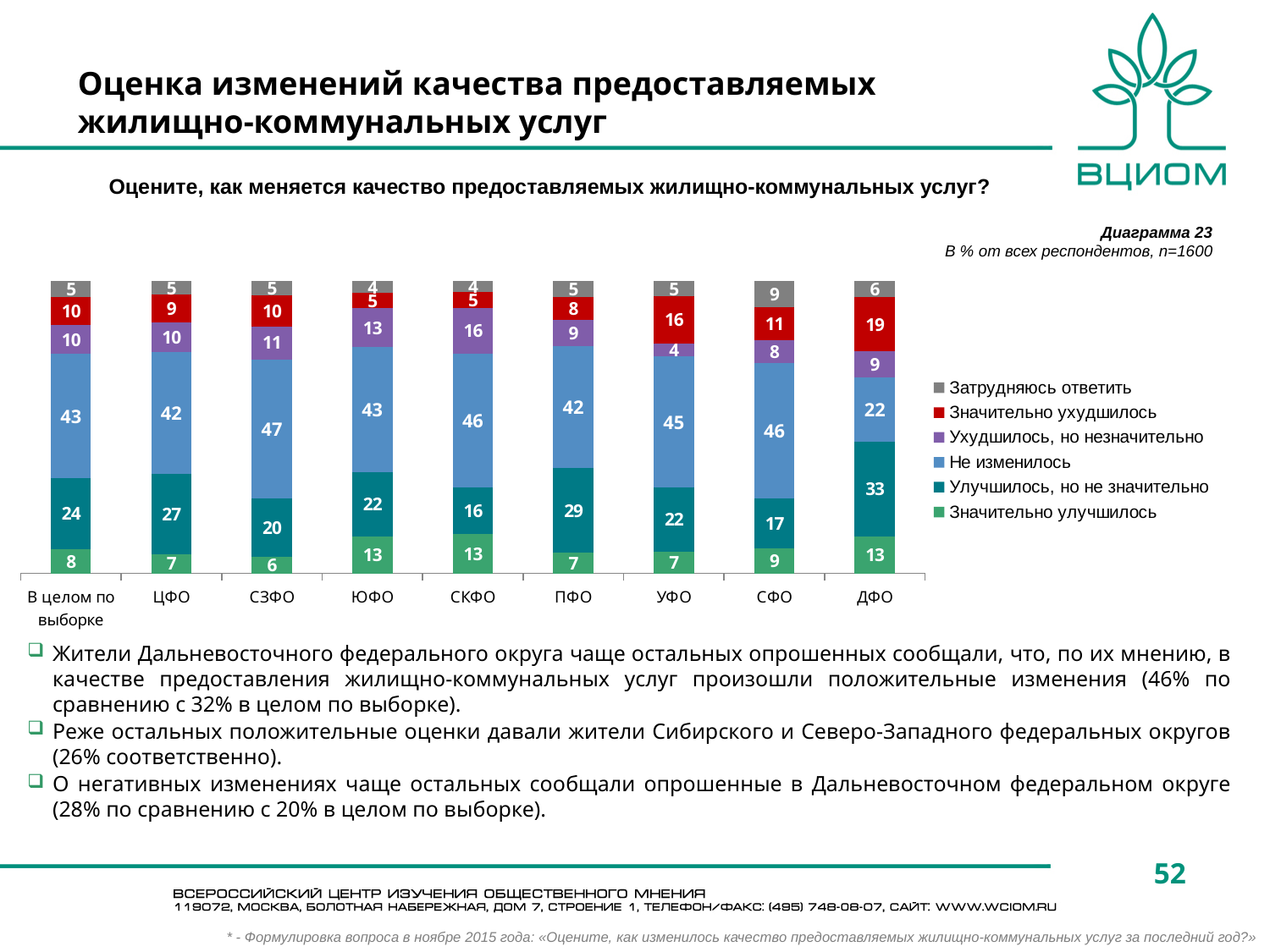
What is the total of the stacked bar for В целом по выборке? 100 What kind of chart is shown on the slide? Stacked bar chart Which has the larger "Значительно ухудшилось" value, УФО or СФО? УФО What is the value of "Затрудняюсь ответить" for СФО? 9 What is the value of "Значительно ухудшилось" for ДФО? 19 How many series does the legend list? 6 Which category has the highest value for "Улучшилось, но не значительно"? ДФО How many categories are shown on the x axis? 9 What is the value of "Не изменилось" for СЗФО? 47 Which category has the lowest value for "Не изменилось"? ДФО What is the difference between the "Значительно улучшилось" values for ДФО and В целом по выборке? 5 Which category has the highest value for "Ухудшилось, но незначительно"? СКФО